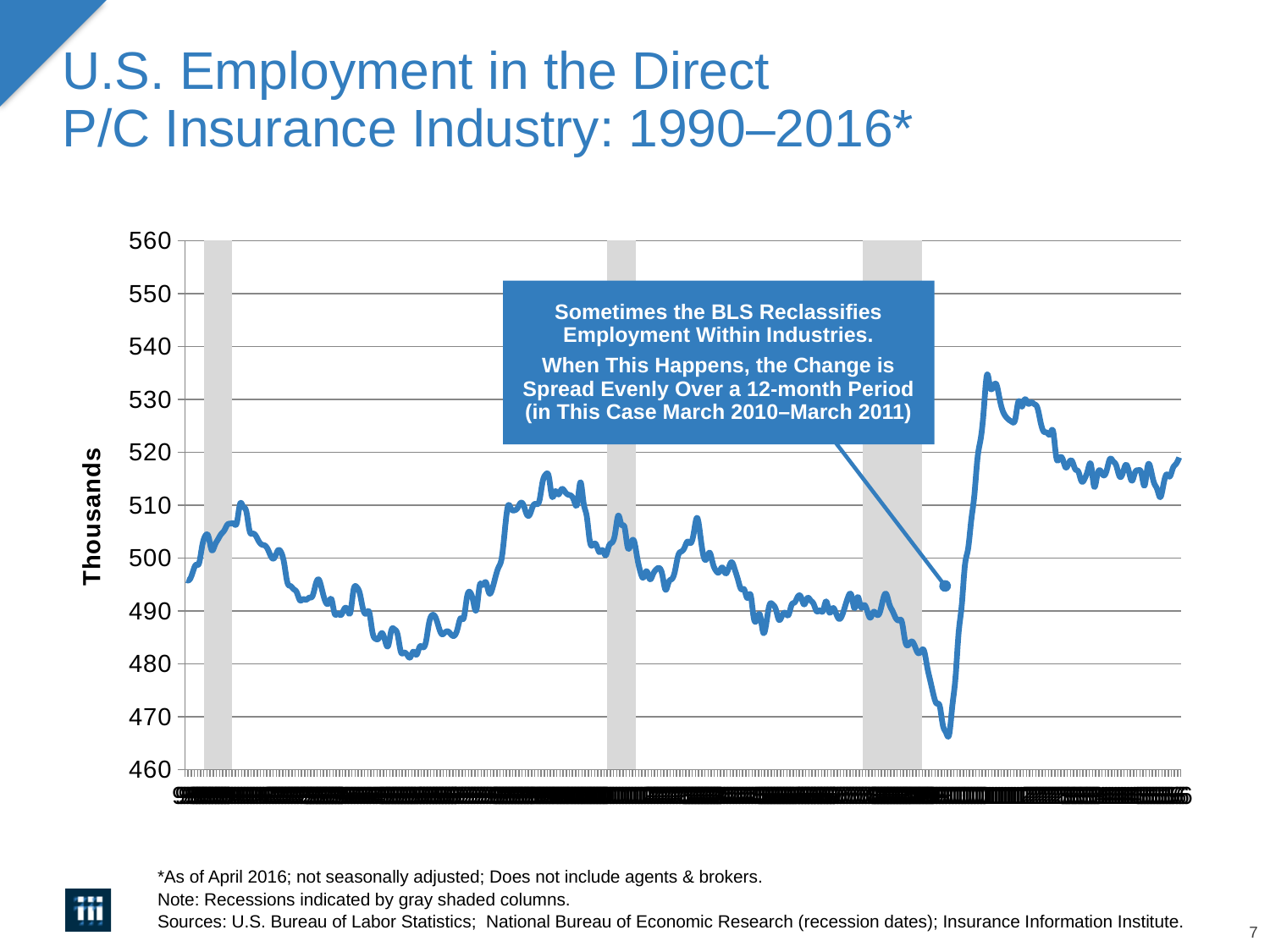
Does the line end higher or lower than where it starts? higher Is the lowest point on the line greater or less than 470? less Is the value at the end of the line (right end) greater or less than 510? greater What is the title of the chart on the slide? U.S. Employment in the Direct P/C Insurance Industry: 1990–2016* What kind of chart is shown on the slide? line chart What is the label on the vertical axis of the chart? Thousands How many gray shaded recession columns are shown on the chart? 3 What is the lowest value shown on the vertical axis? 460 What is the highest value shown on the vertical axis? 560 Is the value at the start of the line (left end) greater or less than 500? less